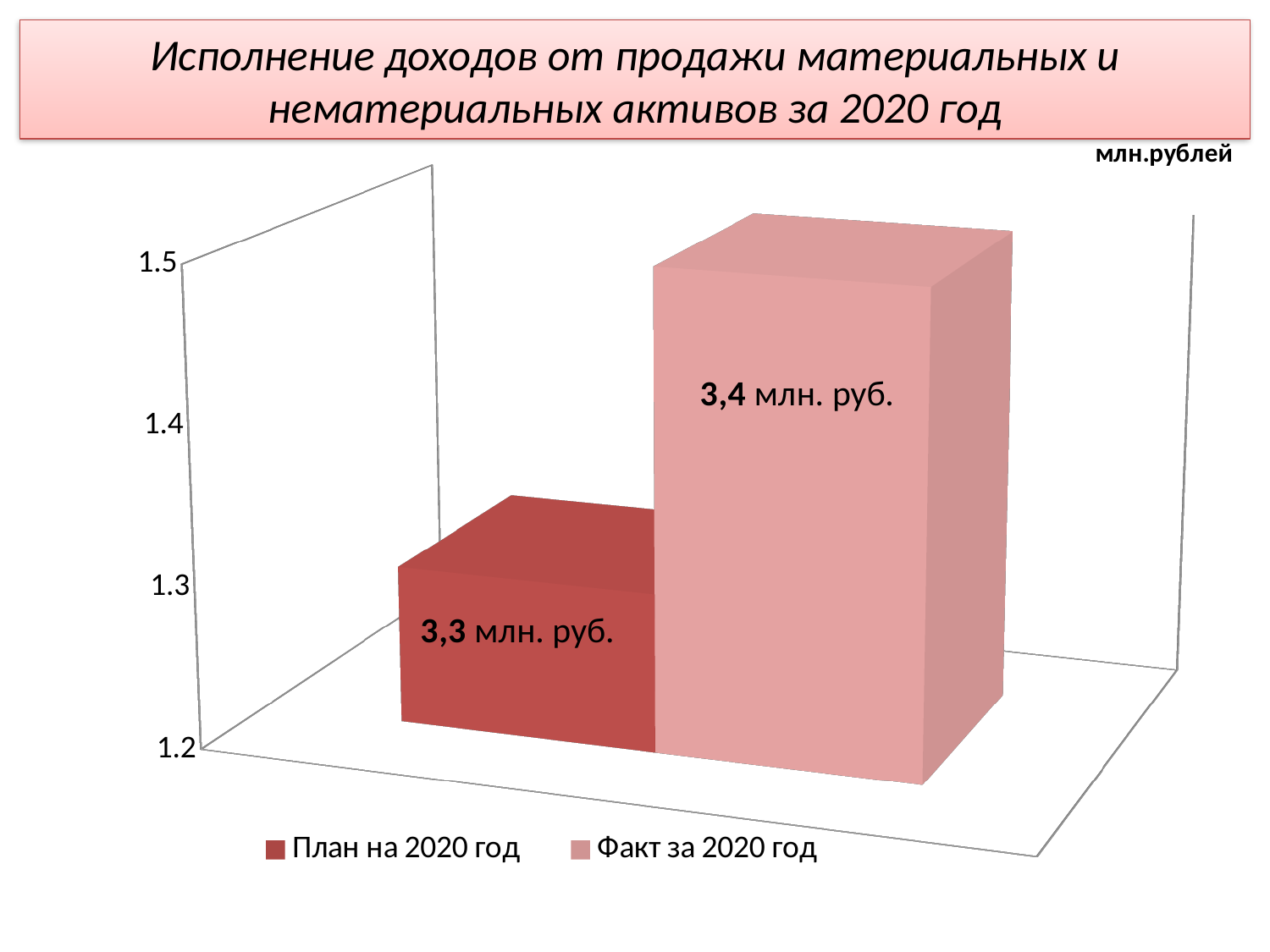
How many bars are plotted on the chart? 2 What is the value shown for План на 2020 год? 3,3 млн. руб. What is the value shown for Факт за 2020 год? 3,4 млн. руб. What unit is indicated in the top right corner of the chart? млн.рублей How many series does the legend list? 2 Which series has the higher value, План на 2020 год or Факт за 2020 год? Факт за 2020 год Which series has the lower value? План на 2020 год What kind of chart is shown on the slide? bar chart By how much does Факт за 2020 год exceed План на 2020 год? 0,1 млн. руб. Is the value for Факт за 2020 год larger or smaller than the value for План на 2020 год? larger What is the title of the chart? Исполнение доходов от продажи материальных и нематериальных активов за 2020 год